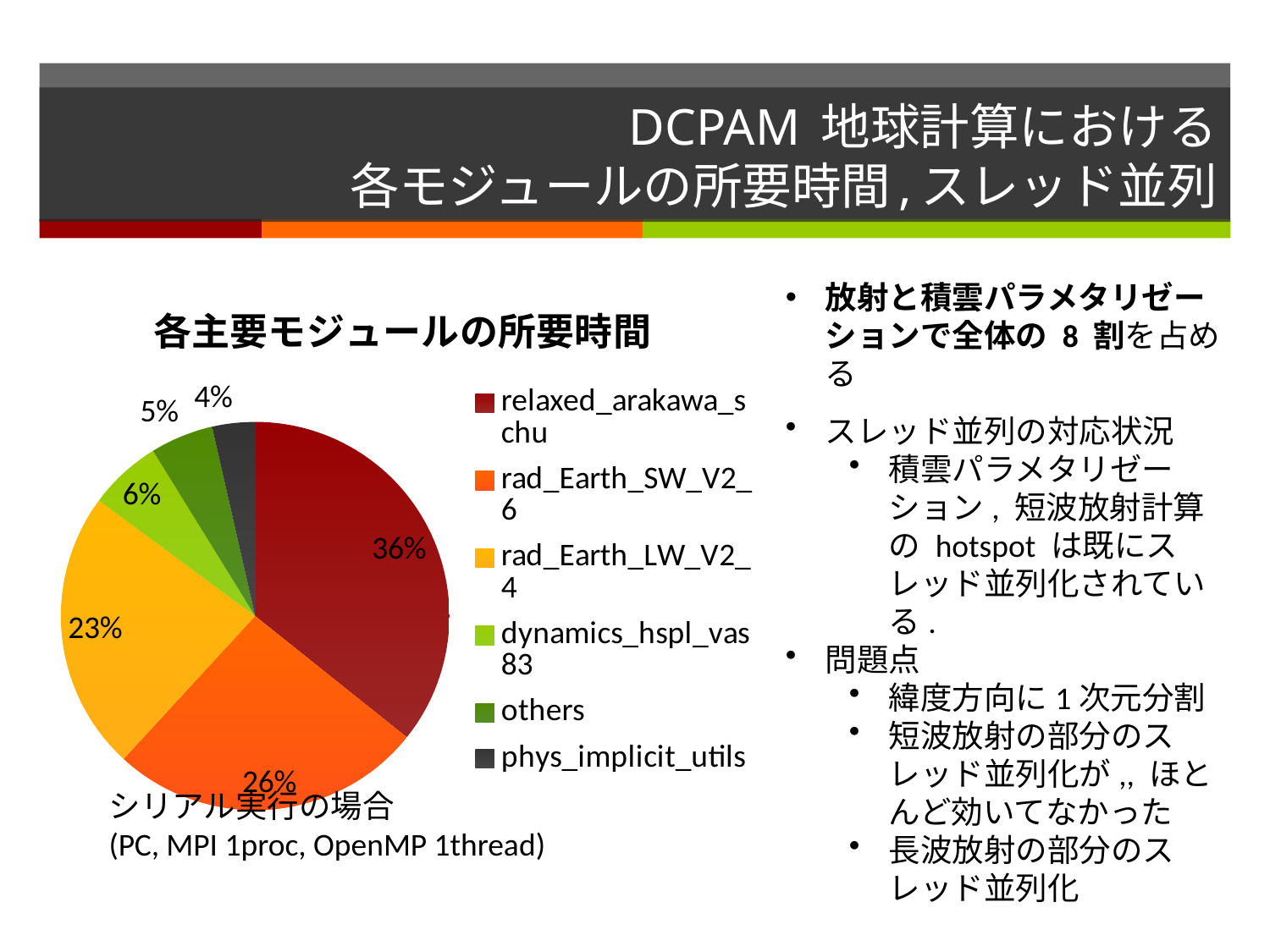
What is the value shown for rad_Earth_SW_V2_6? 26% Which has a larger share, others or phys_implicit_utils? others What kind of chart is shown on the slide? pie chart What is the value shown for rad_Earth_LW_V2_4? 23% What share of the pie does relaxed_arakawa_schu take? 36% Which module has the largest share of the pie? relaxed_arakawa_schu What is the title of the chart? 各主要モジュールの所要時間 Which module has the smallest share of the pie? phys_implicit_utils What is the value shown for dynamics_hspl_vas83? 6% How many slices does the pie chart have? 6 What is the difference between the shares of relaxed_arakawa_schu and rad_Earth_LW_V2_4? 13% How many entries does the legend list? 6